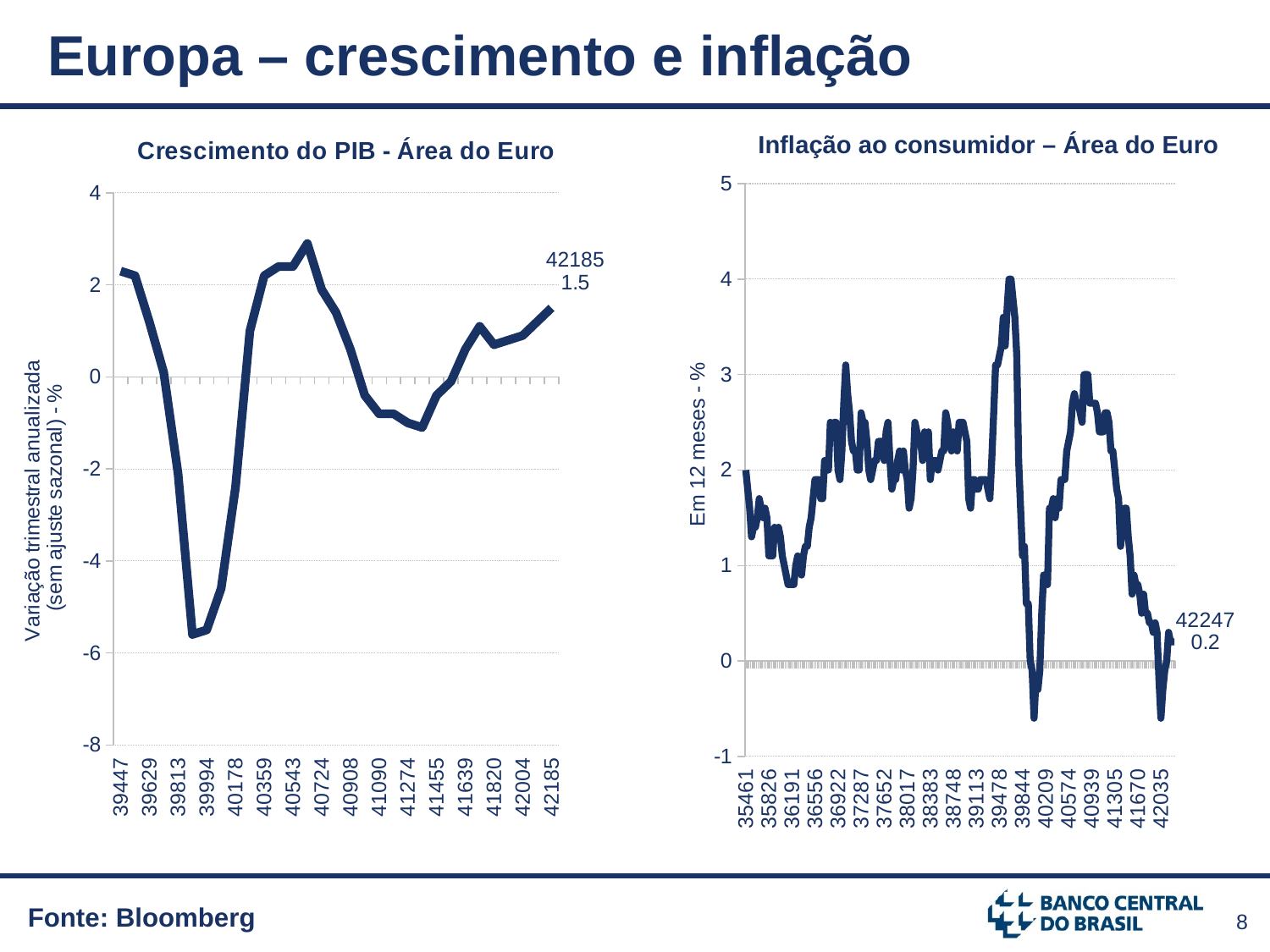
What kind of chart is the left chart, Crescimento do PIB - Área do Euro? line chart What is the y-axis label of the right chart, Inflação ao consumidor – Área do Euro? Em 12 meses - % On the right chart (Inflação ao consumidor – Área do Euro), what value is shown by the data label at the last point, 42247? 0.2 What is the title of the left chart? Crescimento do PIB - Área do Euro What kind of chart is the right chart, Inflação ao consumidor – Área do Euro? line chart On the left chart (Crescimento do PIB - Área do Euro), is the lowest value of the line greater or less than -4? less On the right chart (Inflação ao consumidor – Área do Euro), is the value at the first point (35461) greater or less than 1? greater On the left chart (Crescimento do PIB - Área do Euro), what value is shown by the data label at the last point, 42185? 1.5 On the right chart (Inflação ao consumidor – Área do Euro), is the lowest value of the line greater or less than 0? less Comparing the labelled final values, which is larger: the last value on the left chart (1.5) or the last value on the right chart (0.2)? the left chart (1.5)